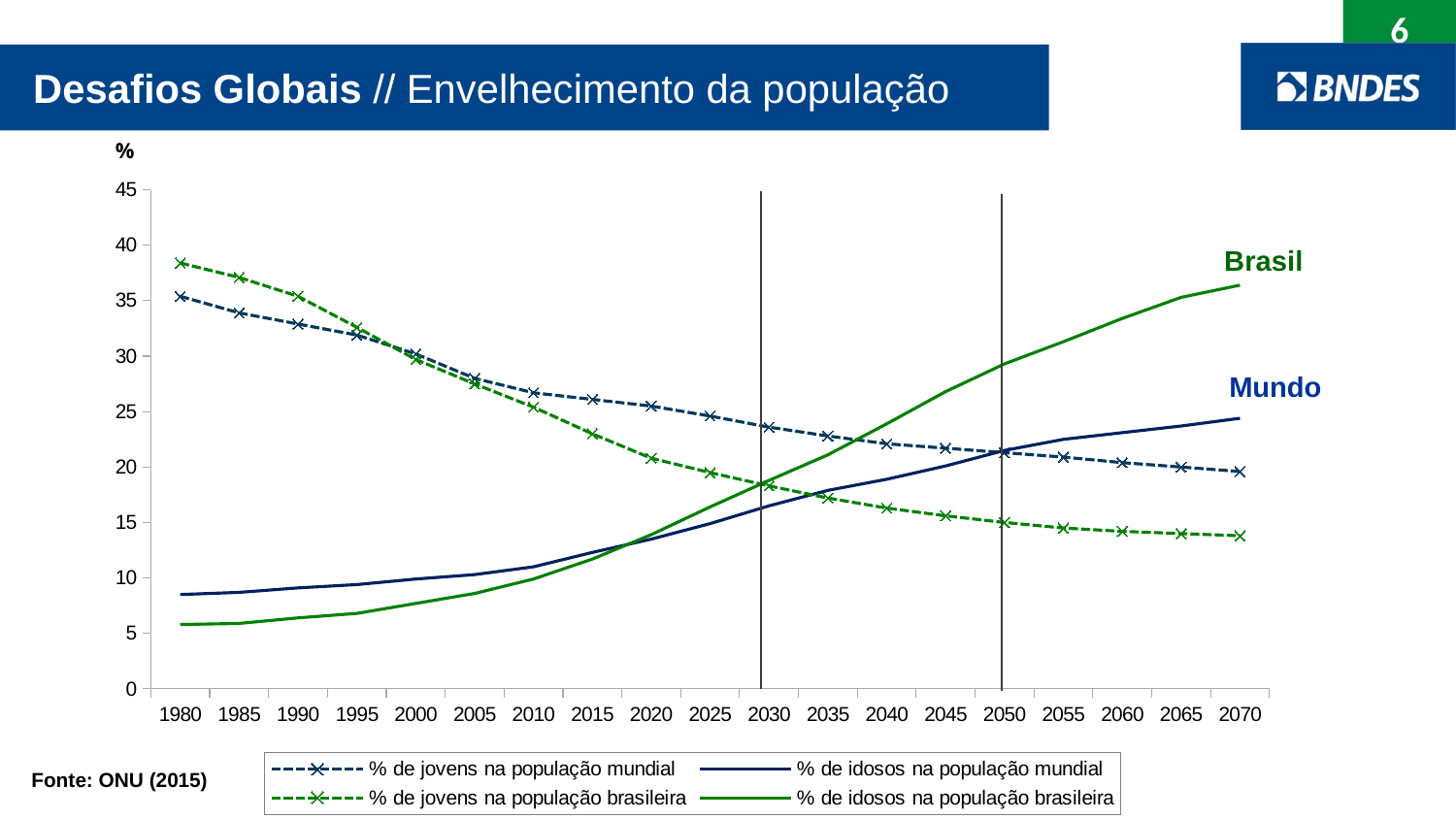
Is the value for '% de jovens na população brasileira' in 2070 greater or less than 15? less Is the value for '% de idosos na população mundial' in 1980 greater or less than 10? less In 2070, which is larger: '% de idosos na população brasileira' or '% de idosos na população mundial'? % de idosos na população brasileira Does the series '% de jovens na população mundial' rise or fall from 1980 to 2070? fall How many years are labelled on the x axis? 19 Which series has the highest value in 2070? % de idosos na população brasileira Does the series '% de idosos na população brasileira' rise or fall from 1980 to 2070? rise How many series does the legend list? 4 What source is cited for the chart? ONU (2015) What kind of chart is shown on the slide? line chart Which series has the lowest value in 1980? % de idosos na população brasileira Is the value for '% de jovens na população brasileira' in 1980 greater or less than 35? greater